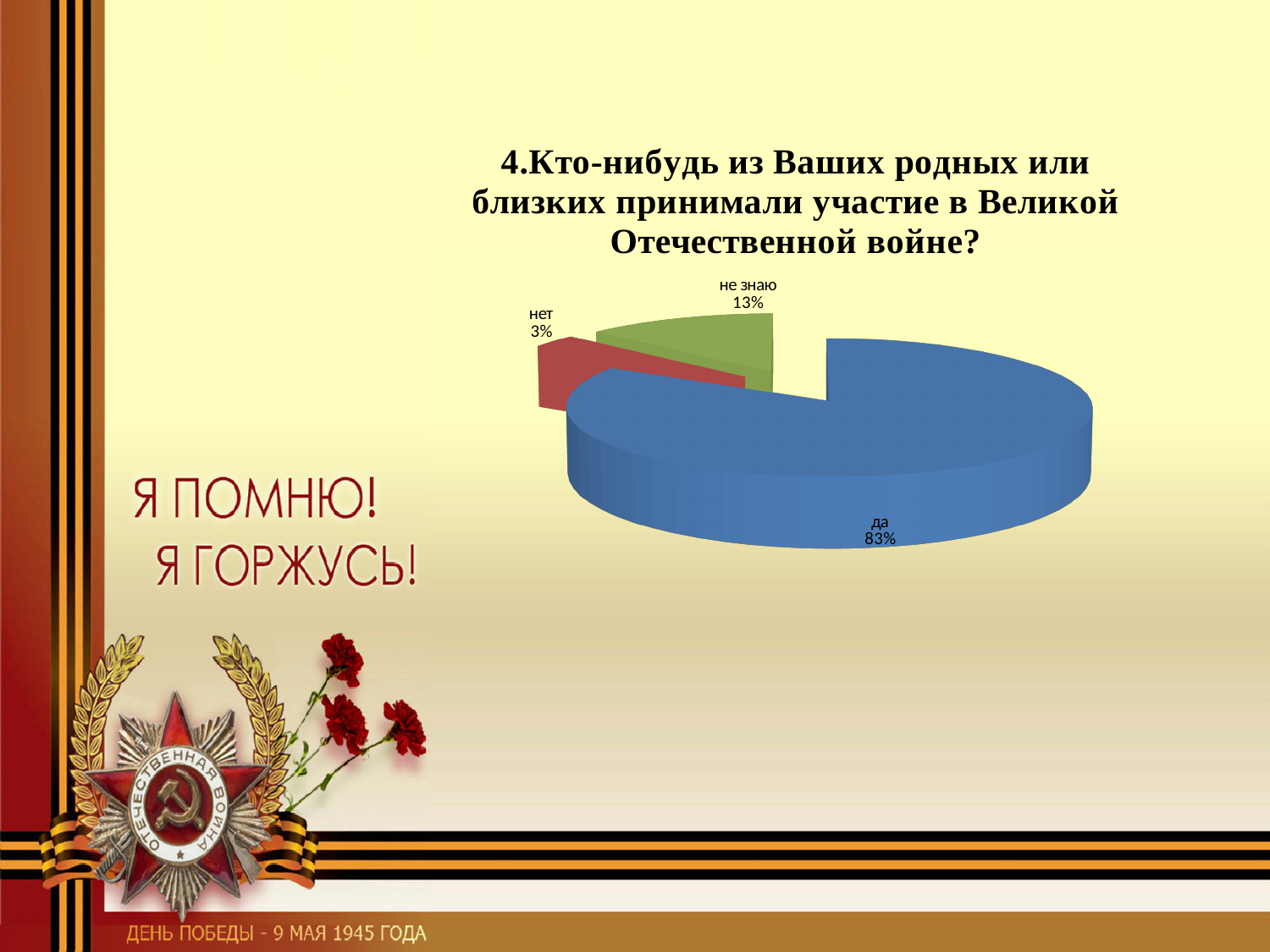
Which slice is larger, "не знаю" or "нет"? не знаю What is the difference in percentage points between the "да" and "не знаю" slices? 70 What share of the pie does the "не знаю" slice represent? 13% Which category has the smallest slice of the pie? нет How many categories are shown in the pie chart? 3 What colour is the "да" slice of the pie? blue What share of the pie does the "нет" slice represent? 3% Which category has the largest slice of the pie? да What is the difference in percentage points between the "не знаю" and "нет" slices? 10 What colour is the "не знаю" slice of the pie? green What share of the pie does the "да" slice represent? 83% What kind of chart is shown on the slide? pie chart